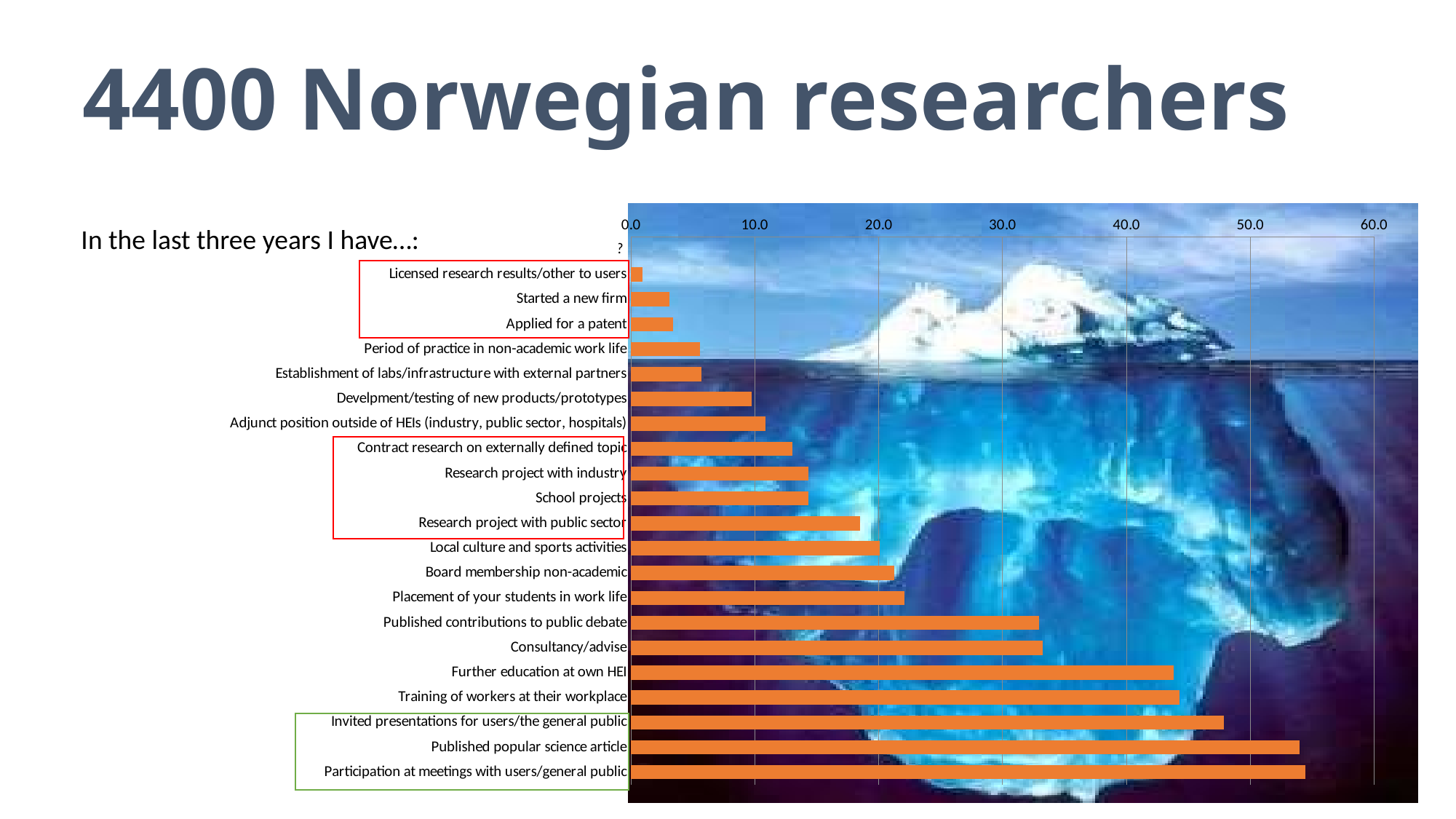
Is the value for Period of practice in non-academic work life greater or less than 10.0? less What kind of chart is shown on the slide? bar chart What is the highest value shown on the chart's horizontal axis? 60.0 Is the value for Published popular science article greater or less than 50.0? greater Is the value for Consultancy/advise greater or less than 30.0? greater Which is larger, the value for Further education at own HEI or the value for Consultancy/advise? Further education at own HEI What colour are the bars in the chart? orange Which is larger, the value for Research project with public sector or the value for School projects? Research project with public sector Which category has the lowest value in the chart? Licensed research results/other to users